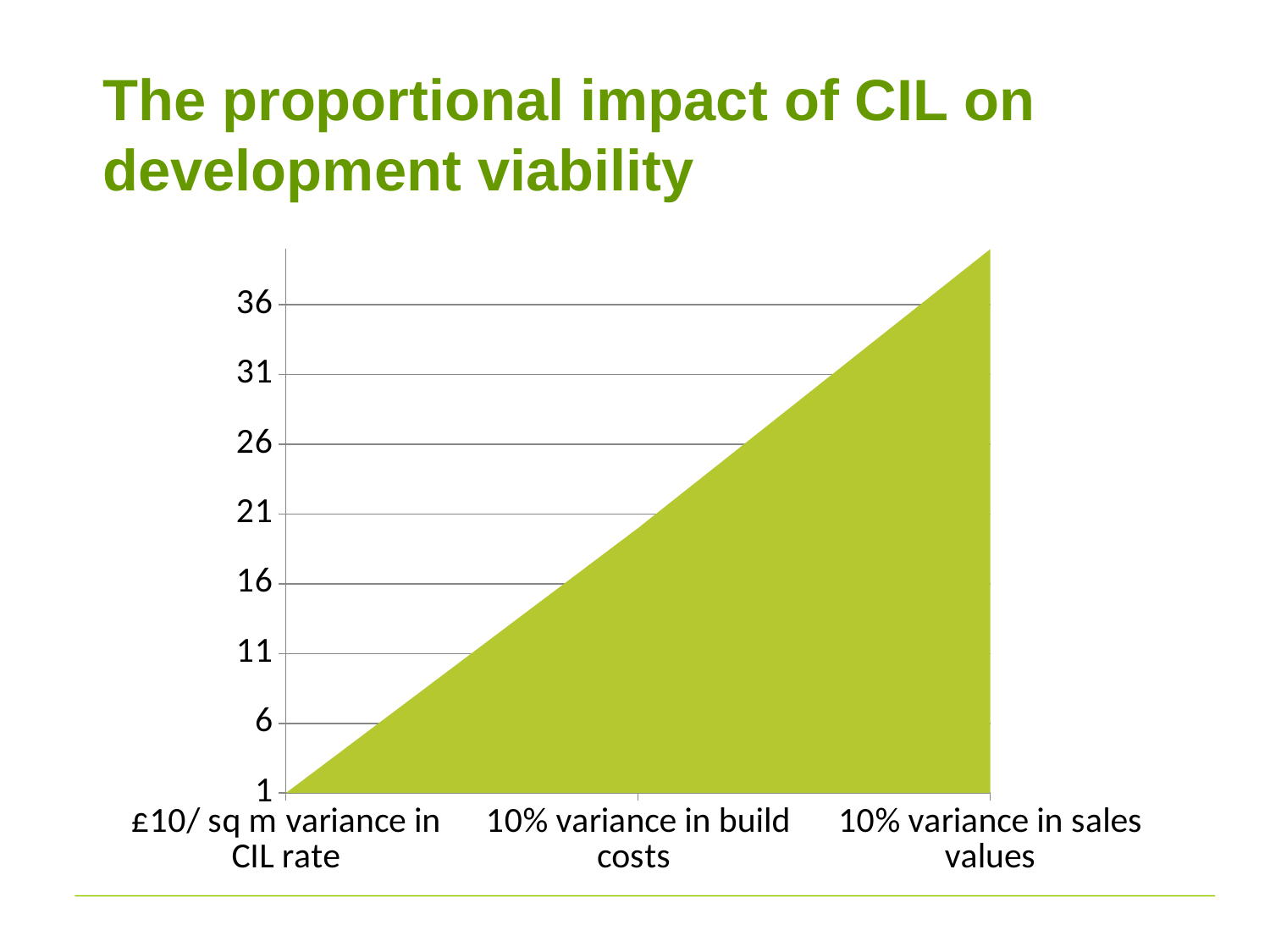
What is the title of the slide containing the chart? The proportional impact of CIL on development viability How many categories are plotted along the x axis? 3 Do the values rise or fall from left to right along the x axis? Rise Which category has the lowest value? £10/ sq m variance in CIL rate What kind of chart is shown on the slide? Area chart Which is larger: the value for 10% variance in build costs or the value for £10/ sq m variance in CIL rate? 10% variance in build costs Is the value for 10% variance in sales values greater or less than 36? greater Which category has the highest value? 10% variance in sales values What is the value for £10/ sq m variance in CIL rate? 1 Is the value for 10% variance in build costs greater or less than 11? greater